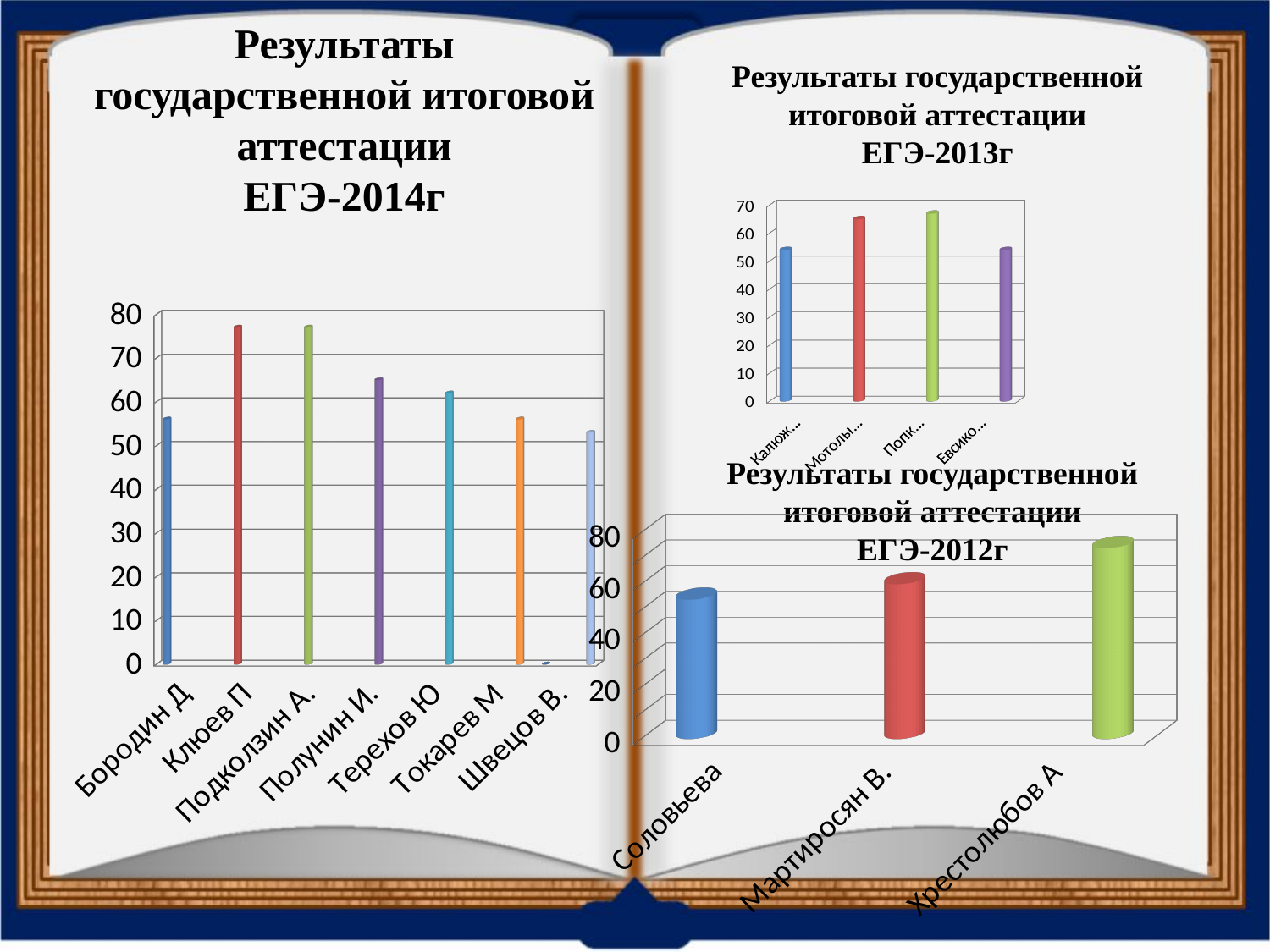
What kind of chart is the ЕГЭ-2014г chart? bar chart On the ЕГЭ-2012г chart, which category has the highest value? Хрестолюбов А On the ЕГЭ-2012г chart, how many categories are shown? 3 On the ЕГЭ-2012г chart, which category has the lowest value? Соловьева On the ЕГЭ-2014г chart, how many categories (students) are shown on the x axis? 7 On the ЕГЭ-2014г chart, which is larger, the value for Клюев П or the value for Бородин Д? Клюев П On the ЕГЭ-2014г chart, is the value for Швецов В. greater or less than 60? less On the ЕГЭ-2012г chart, is the value for Хрестолюбов А greater or less than 60? greater On the ЕГЭ-2014г chart, is the value for Клюев П greater or less than 70? greater On the ЕГЭ-2013г chart, how many bars are shown? 4